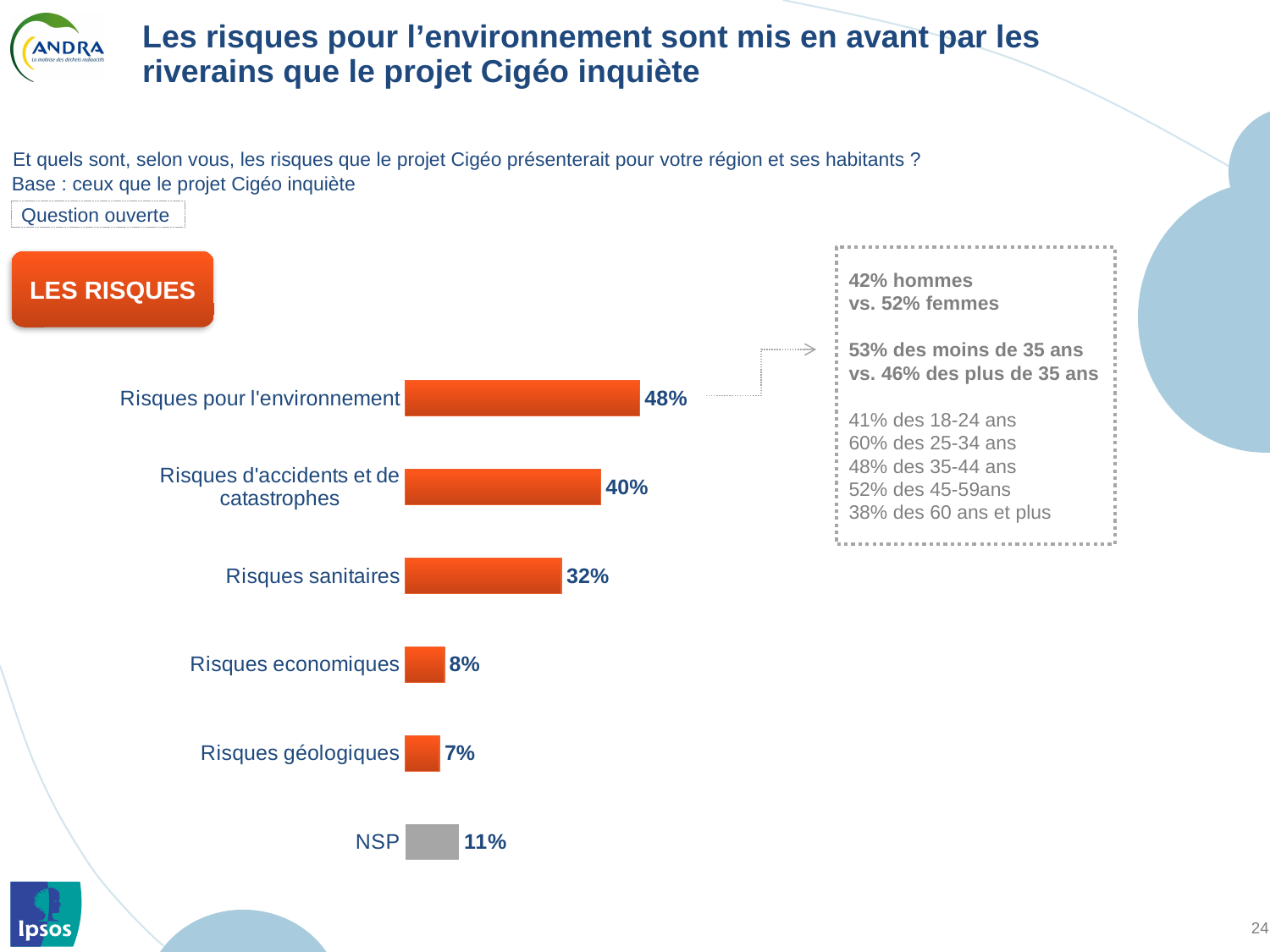
What is the value for "NSP"? 11% What is the value for "Risques sanitaires"? 32% How many categories are shown in the chart? 6 What is the difference between "Risques economiques" and "Risques géologiques"? 1% Which bar is coloured grey rather than orange? NSP Which is larger, "Risques d'accidents et de catastrophes" or "Risques sanitaires"? Risques d'accidents et de catastrophes Which category has the lowest value? Risques géologiques Which category has the highest value? Risques pour l'environnement What is the difference between "Risques pour l'environnement" and "Risques sanitaires"? 16% What kind of chart is shown on the slide? Bar chart What is the value for "Risques pour l'environnement"? 48% What is the value for "Risques d'accidents et de catastrophes"? 40%